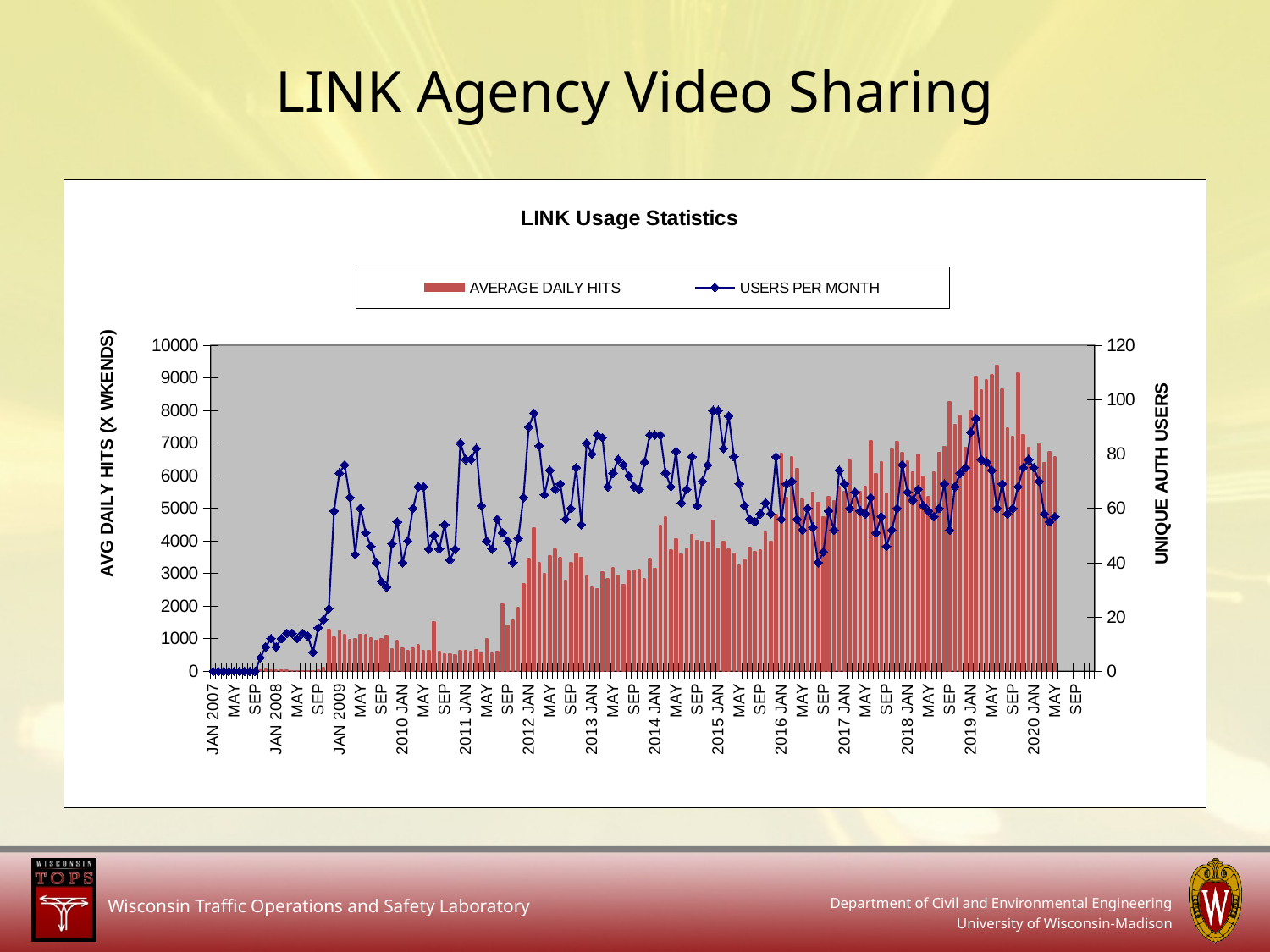
What is the highest tick value on the right vertical axis? 120 Is the peak value of AVERAGE DAILY HITS in 2019 greater or less than 8000? greater Which series is drawn as bars in the chart? AVERAGE DAILY HITS Is the value of AVERAGE DAILY HITS in JAN 2010 greater or less than 2000? less Do the AVERAGE DAILY HITS bars generally rise or fall from 2010 to 2019? rise How many series does the chart legend list? 2 What kind of chart is shown on the slide? A combination bar and line chart What is the title of the chart on the slide? LINK Usage Statistics Does USERS PER MONTH rise or fall between JAN 2007 and JAN 2009? rise What is the highest tick value on the left vertical axis? 10000 Is the peak value of USERS PER MONTH in early 2012 greater or less than 80? greater